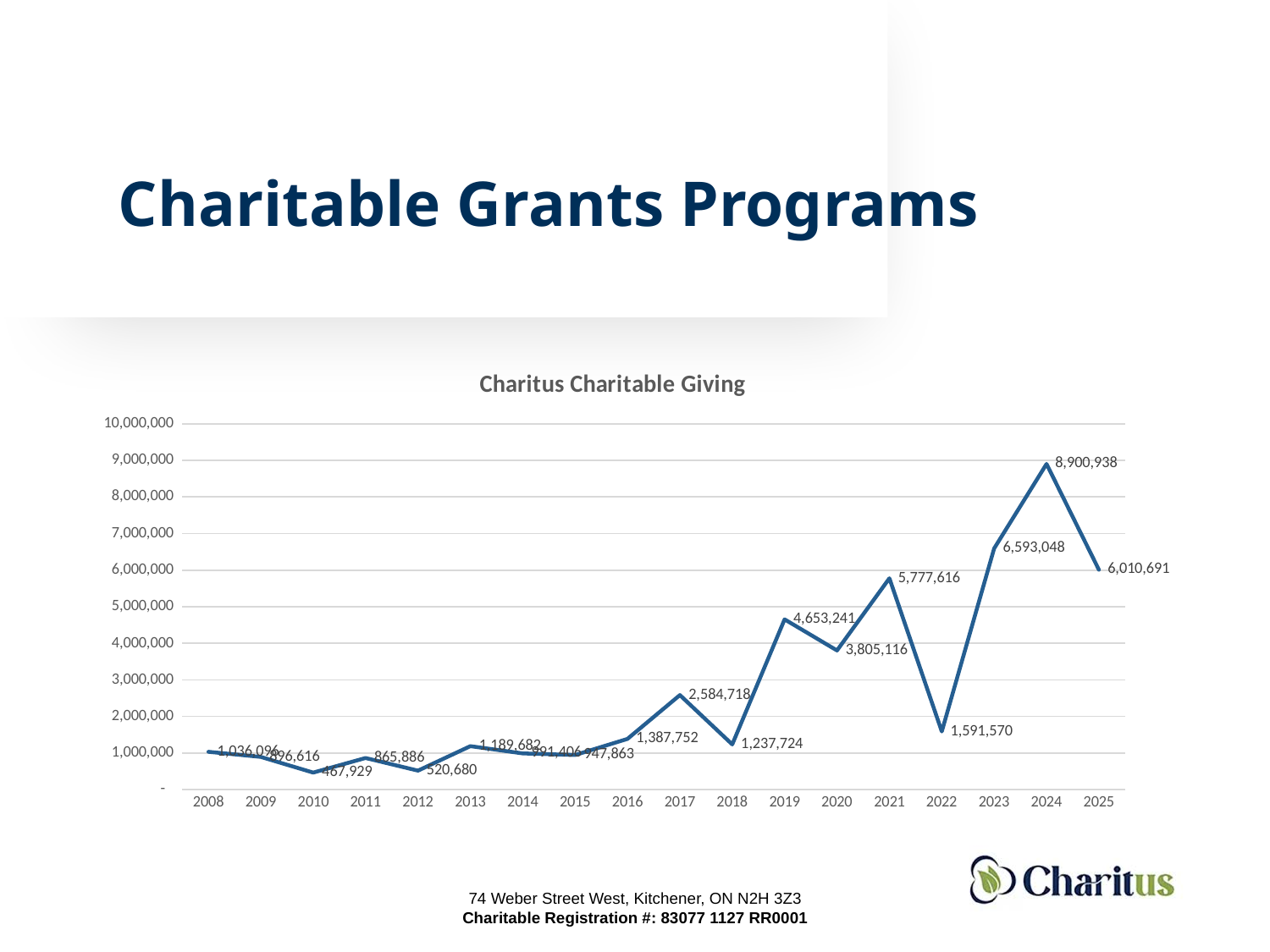
What is the difference between the 2023 and 2022 values in the Charitus Charitable Giving chart? 5,001,478 Which year has the larger value in the Charitus Charitable Giving chart, 2021 or 2023? 2023 Which year has the lowest value in the Charitus Charitable Giving chart? 2010 What is the value for 2024 in the Charitus Charitable Giving chart? 8,900,938 What is the value for 2019 in the Charitus Charitable Giving chart? 4,653,241 Does the value rise or fall from 2021 to 2022 in the Charitus Charitable Giving chart? fall What is the value for 2022 in the Charitus Charitable Giving chart? 1,591,570 How many years are plotted in the Charitus Charitable Giving chart? 18 Is the value for 2022 in the Charitus Charitable Giving chart greater or less than 2,000,000? less Which year has the highest value in the Charitus Charitable Giving chart? 2024 What is the difference between the 2024 and 2025 values in the Charitus Charitable Giving chart? 2,890,247 What kind of chart is the Charitus Charitable Giving chart? line chart